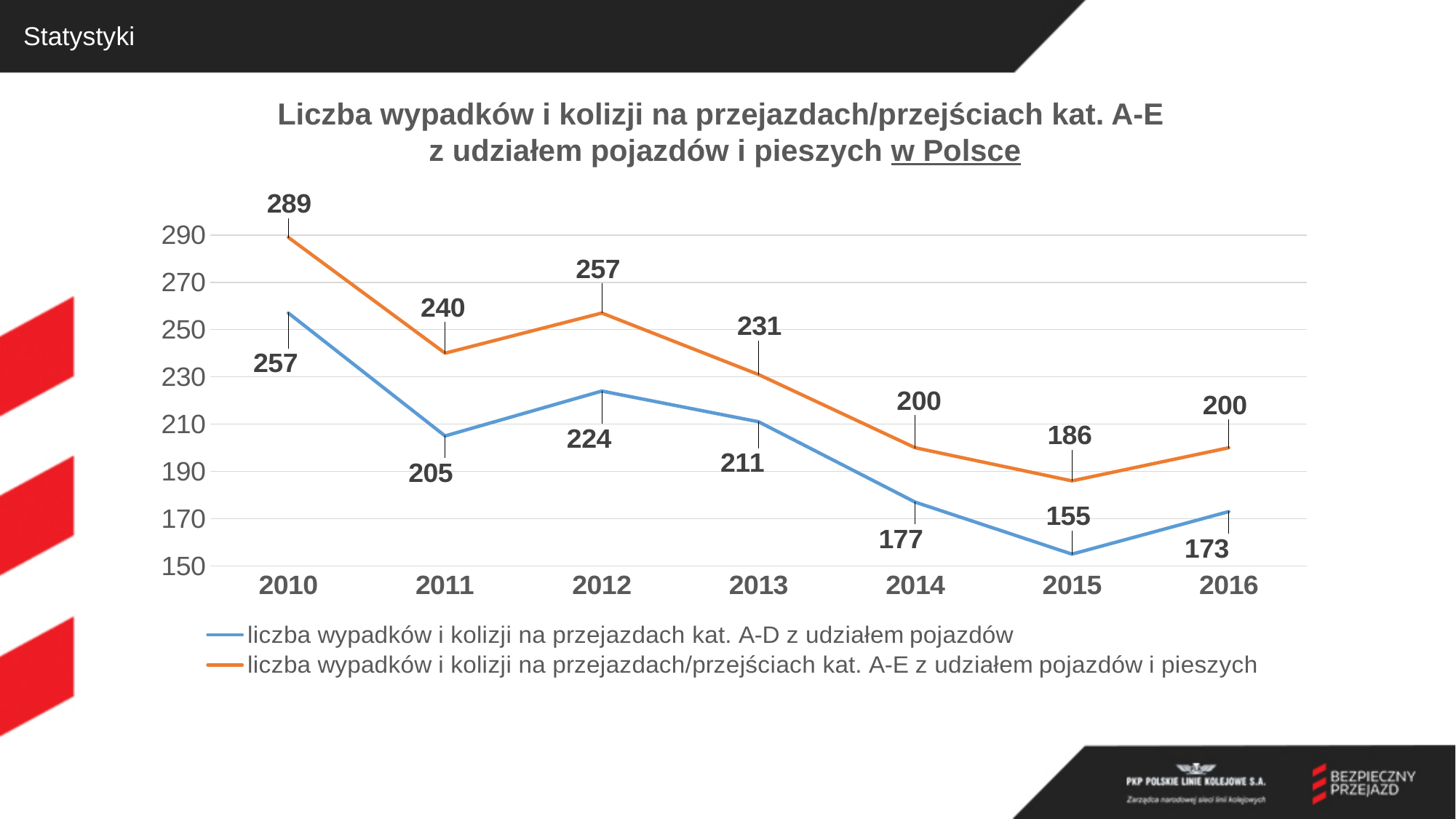
What type of chart is shown on the slide? line chart What is the value for 2010 in the series 'liczba wypadków i kolizji na przejazdach/przejściach kat. A-E z udziałem pojazdów i pieszych'? 289 What is the difference between the two series in 2016? 27 What is the value for 2013 in the series 'liczba wypadków i kolizji na przejazdach kat. A-D z udziałem pojazdów'? 211 What colour is the line for the series 'liczba wypadków i kolizji na przejazdach kat. A-D z udziałem pojazdów'? blue Which is larger for the series 'liczba wypadków i kolizji na przejazdach kat. A-D z udziałem pojazdów': the value for 2012 or the value for 2013? 2012 What is the value for 2015 in the series 'liczba wypadków i kolizji na przejazdach kat. A-D z udziałem pojazdów'? 155 How many years are plotted along the x axis? 7 How many series does the legend list? 2 In which year is the series 'liczba wypadków i kolizji na przejazdach kat. A-D z udziałem pojazdów' highest? 2010 In which year is the series 'liczba wypadków i kolizji na przejazdach/przejściach kat. A-E z udziałem pojazdów i pieszych' lowest? 2015 Overall, do the values of the series 'liczba wypadków i kolizji na przejazdach/przejściach kat. A-E z udziałem pojazdów i pieszych' rise or fall from 2010 to 2016? fall